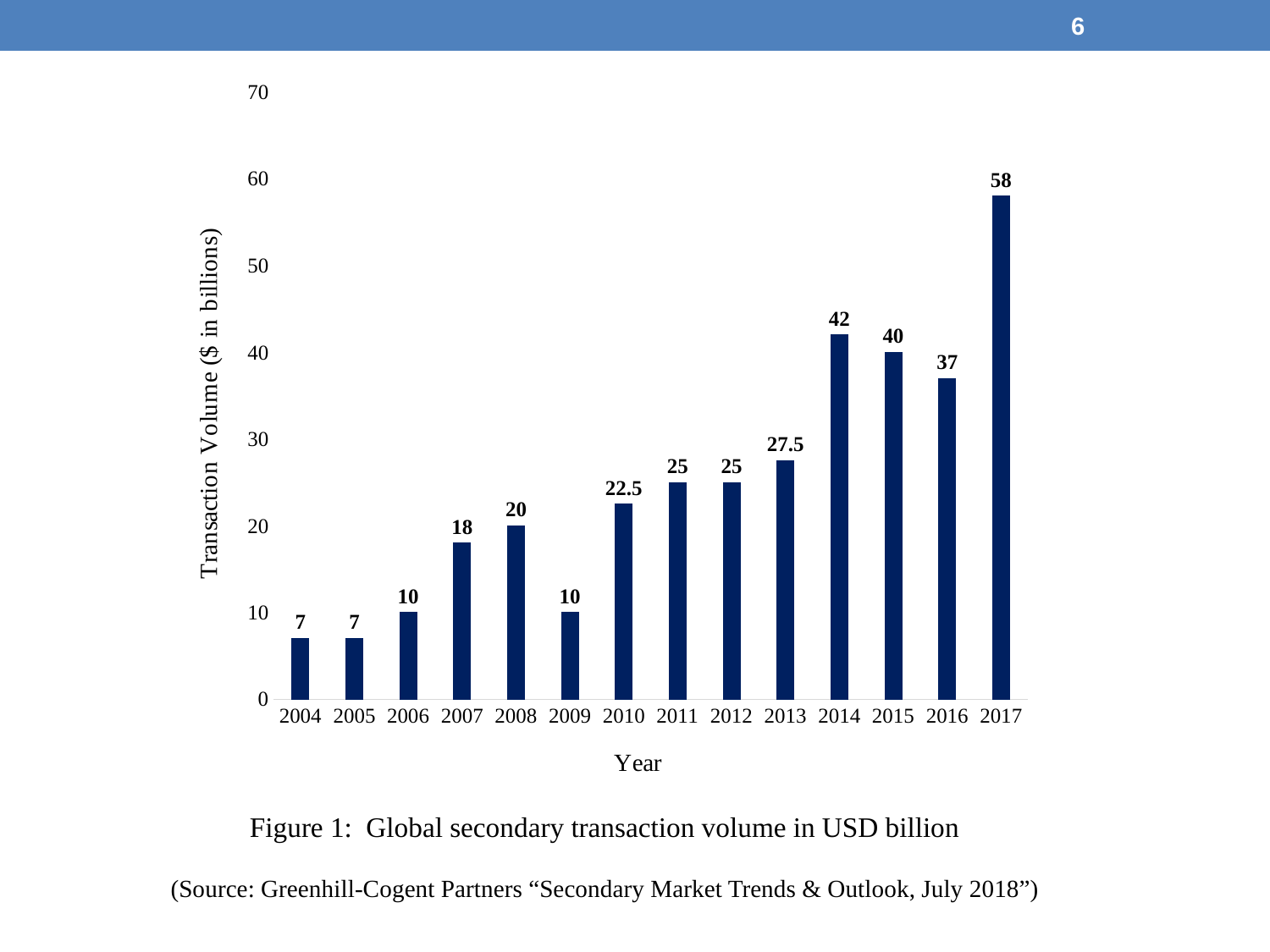
What is the transaction volume for 2010? 22.5 Which year has the larger transaction volume, 2009 or 2008? 2008 What is the difference in transaction volume between 2013 and 2012? 2.5 What is the difference in transaction volume between 2017 and 2014? 16 What is the transaction volume for 2016? 37 How many years are shown on the x axis? 14 What kind of chart is shown on the slide? Bar chart Which year has the highest transaction volume? 2017 Is the value for 2015 greater or less than 30? greater What is the caption of the figure? Figure 1: Global secondary transaction volume in USD billion What is the label of the y axis? Transaction Volume ($ in billions) Do the transaction volumes generally rise or fall from 2009 to 2014? Rise